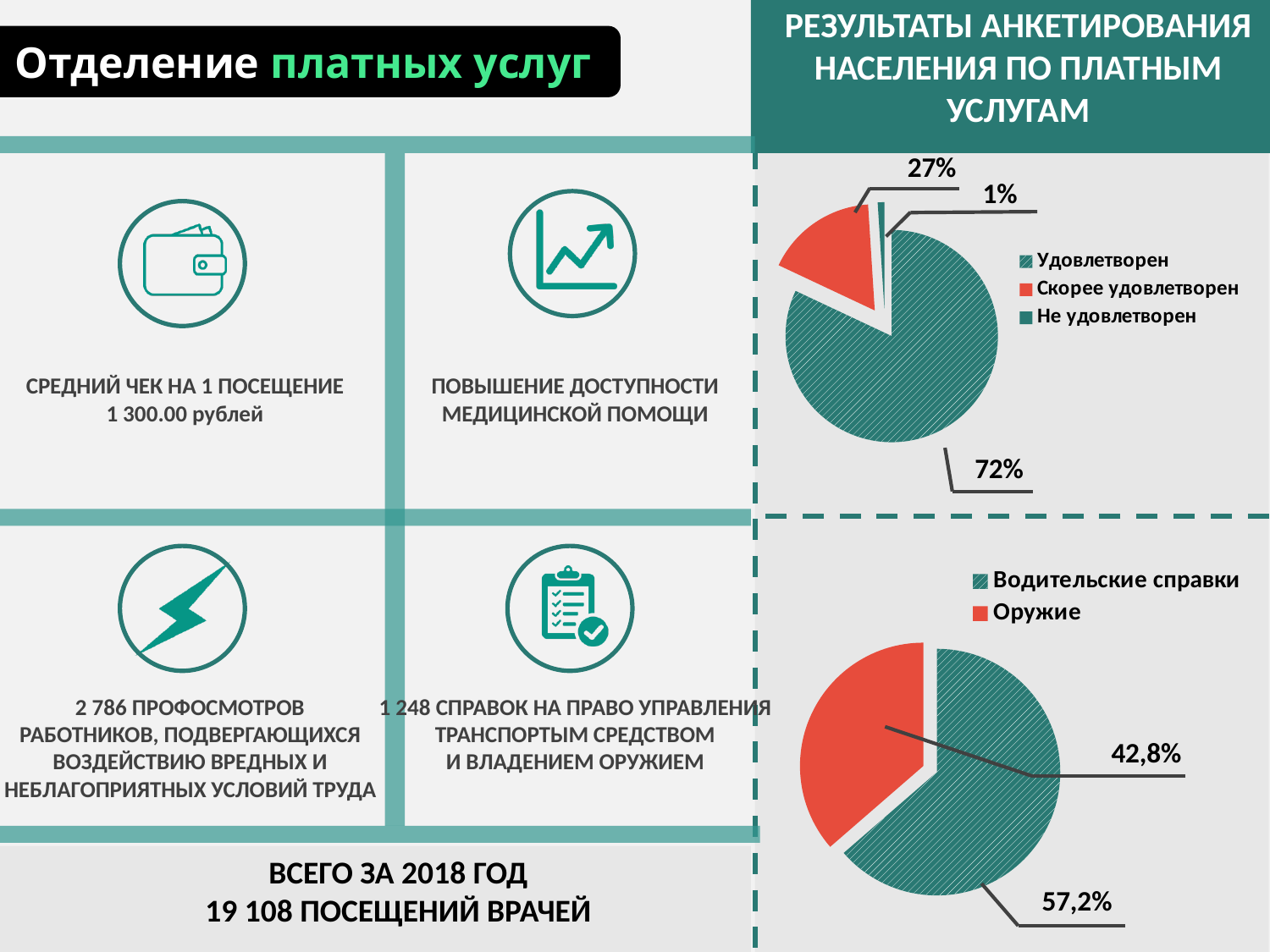
In the top pie chart, what share is labelled for Удовлетворен? 72% In the bottom pie chart, what share is labelled for Оружие? 42,8% What type of chart is the bottom chart on the slide? Pie chart How many categories does the legend of the top pie chart list? 3 In the top pie chart, what is the difference in percentage points between Удовлетворен and Скорее удовлетворен? 45 In the top pie chart, which category has the largest slice? Удовлетворен How many slices does the bottom pie chart have? 2 In the bottom pie chart, which is larger: Водительские справки or Оружие? Водительские справки In the top pie chart, which category has the smallest slice? Не удовлетворен In the top pie chart, what share is labelled for Не удовлетворен? 1% In the top pie chart, what share is labelled for Скорее удовлетворен? 27% In the bottom pie chart, what share is labelled for Водительские справки? 57,2%